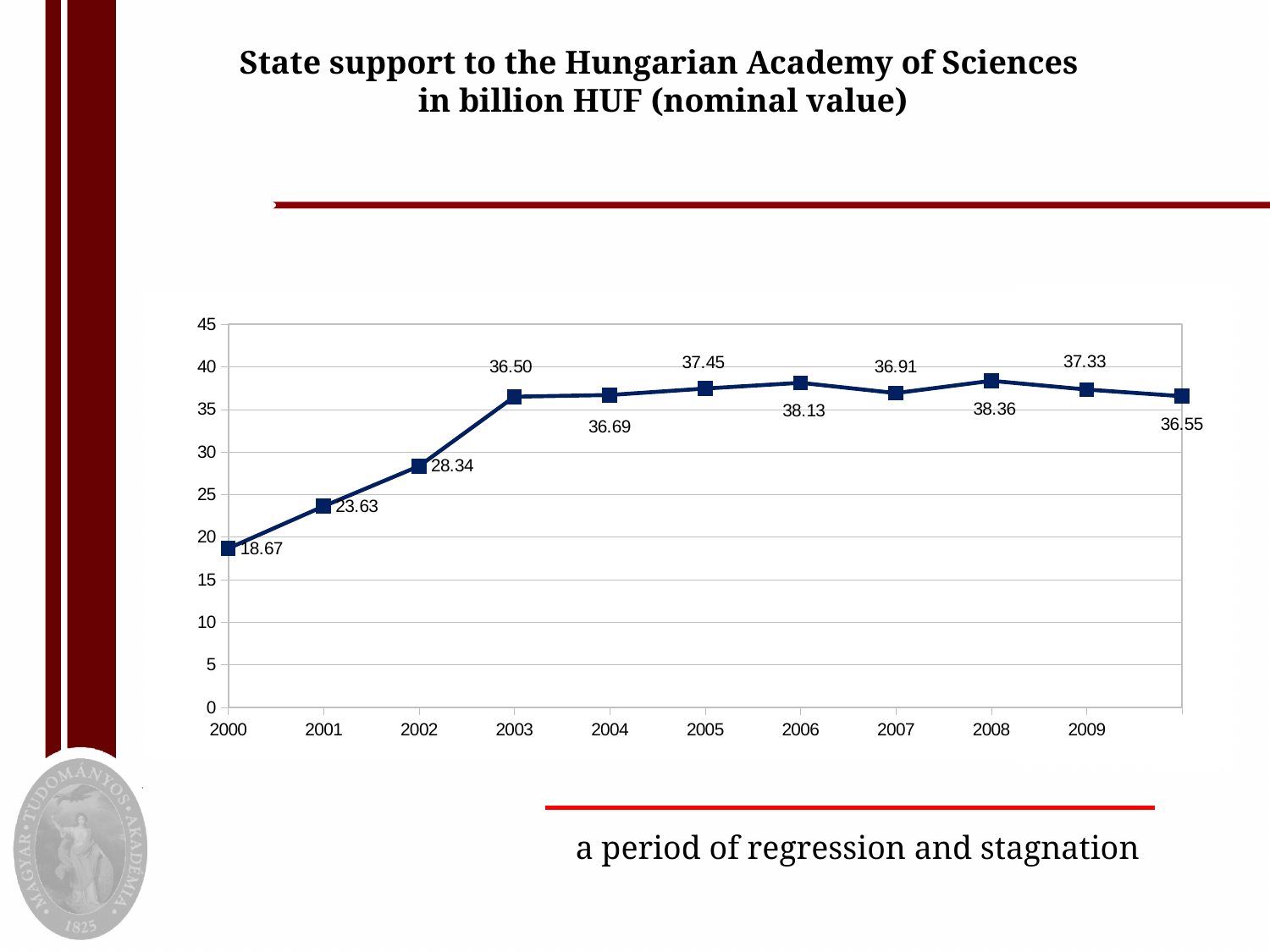
Which year has the lowest value on the chart? 2000 What type of chart is shown on the slide? line chart Which is larger, the value for 2005 or the value for 2007? 2005 Do the values rise or fall from 2000 to 2003? rise What is the difference between the values for 2003 and 2002? 8.16 What is the value of the last plotted point on the right of the chart? 36.55 What value is shown for 2003? 36.50 Which year has the highest value on the chart? 2008 What was the state support to the Hungarian Academy of Sciences in 2000? 18.67 What is the title of the chart? State support to the Hungarian Academy of Sciences in billion HUF (nominal value) What value is shown for 2006? 38.13 How many data points are plotted on the line? 11